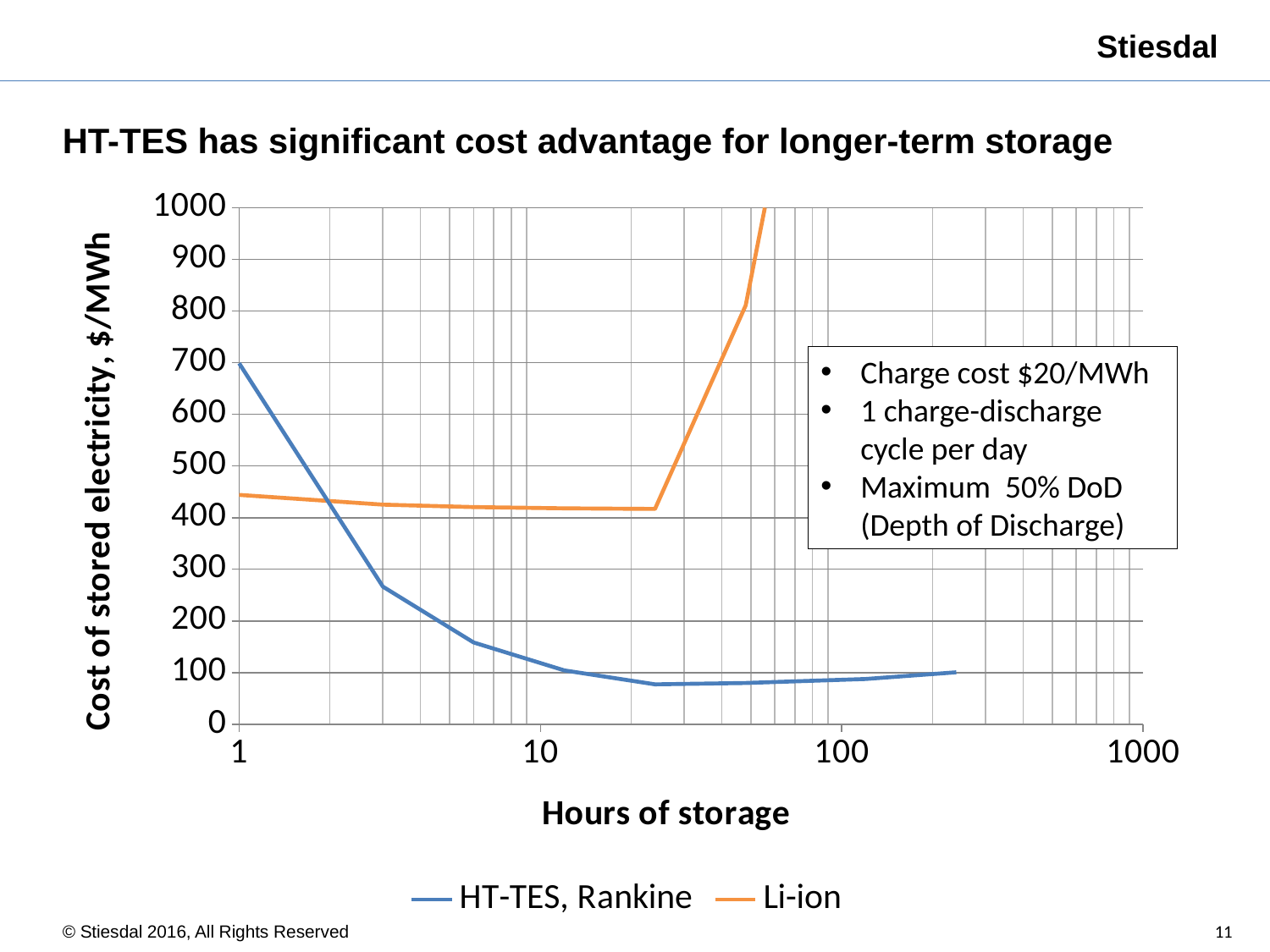
At 10 hours of storage, which series has the higher cost, HT-TES, Rankine or Li-ion? Li-ion Does the HT-TES, Rankine cost rise or fall as hours of storage increase from 1 to 10? fall Is the value for HT-TES, Rankine at 10 hours of storage greater or less than 300? less Is the value for Li-ion at 1 hour of storage greater or less than 400? greater Which series reaches the highest cost shown on the chart? Li-ion What is the title of the chart's x axis? Hours of storage What are the two series named in the legend? HT-TES, Rankine and Li-ion At 1 hour of storage, which series has the higher cost, HT-TES, Rankine or Li-ion? HT-TES, Rankine How many series does the legend list? 2 What kind of chart is shown on the slide? line chart Is the value for HT-TES, Rankine at 100 hours of storage greater or less than 200? less